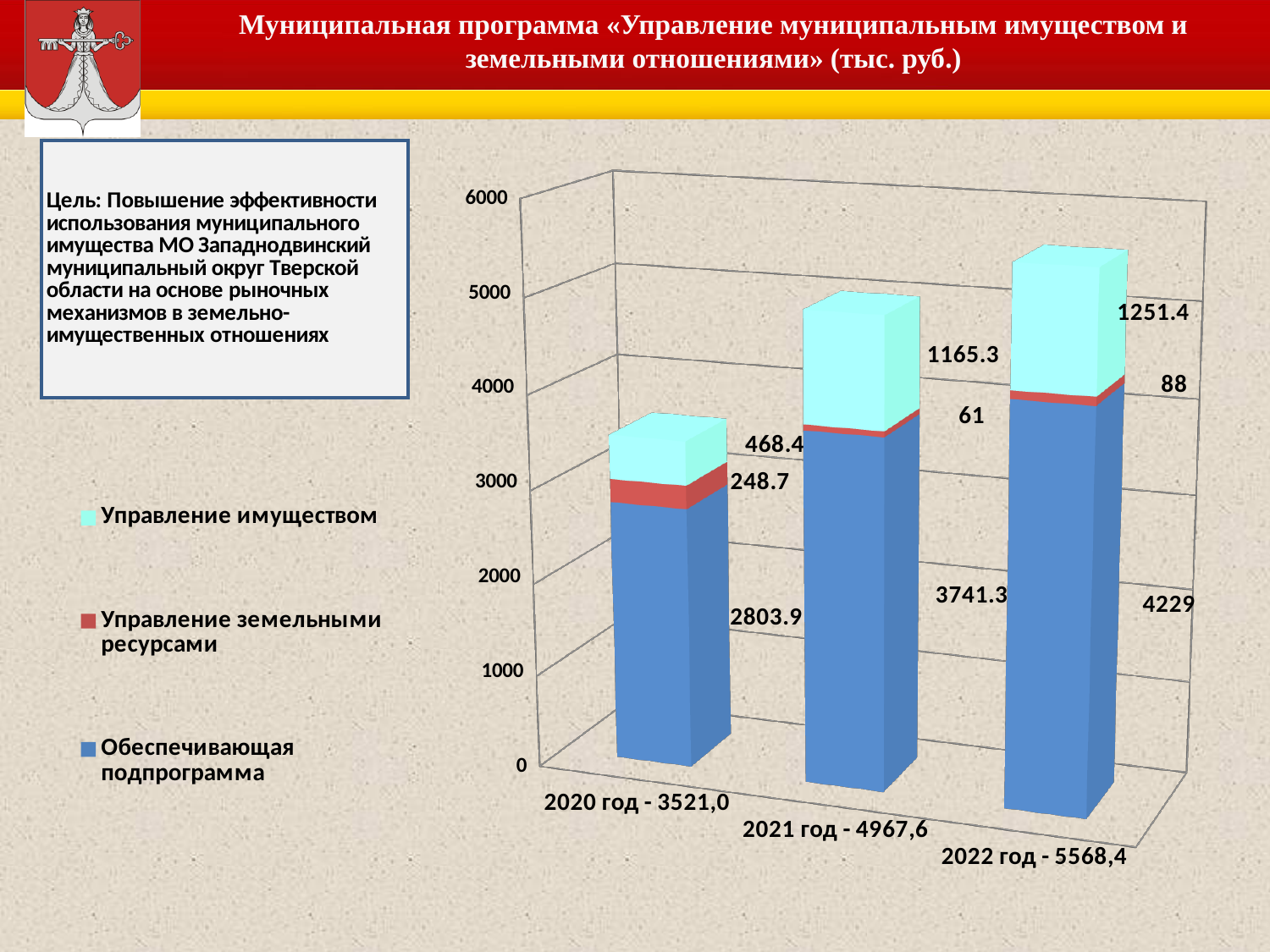
What is the value of Управление земельными ресурсами for 2021? 61 Which year has the lowest value for Управление имуществом? 2020 How many series does the legend list? 3 What is the total of the stacked bar for 2021, as printed in its axis label? 4967,6 What is the value of Управление имуществом for 2021? 1165.3 What is the value of Управление земельными ресурсами for 2022? 88 Which is larger: Управление земельными ресурсами in 2020 or in 2022? 2020 What is the difference between the Управление имуществом values for 2022 and 2021? 86.1 How many years (categories) are shown on the x axis? 3 What is the value of Обеспечивающая подпрограмма for 2020? 2803.9 Which year has the highest value for Обеспечивающая подпрограмма? 2022 What kind of chart is shown on the slide? stacked bar chart